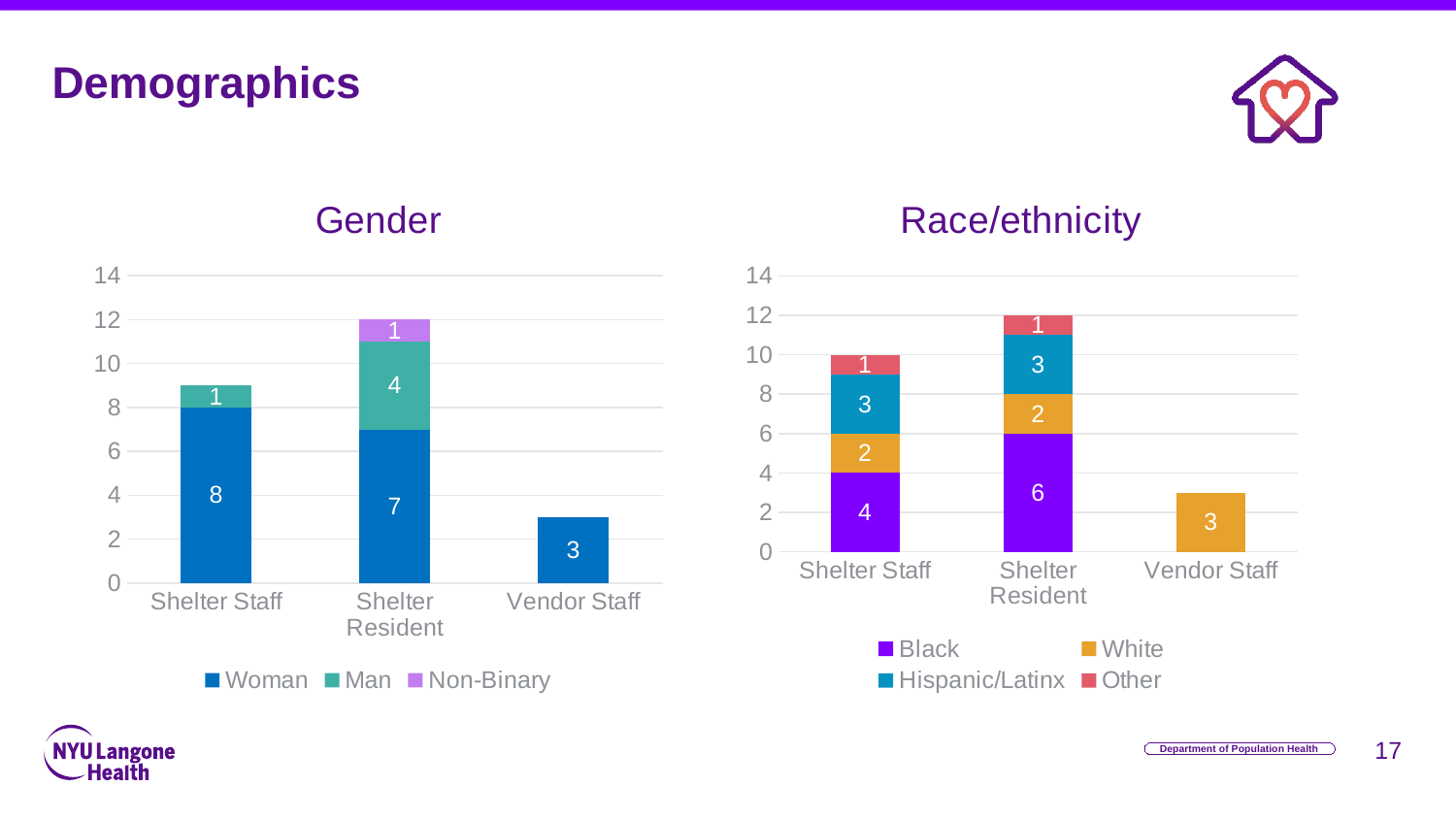
In the Race/ethnicity chart, how many Shelter Resident are Black? 6 In the Gender chart, how many series does the legend list? 3 In the Gender chart, how many Shelter Resident are Man? 4 In the Race/ethnicity chart, which category has the highest total? Shelter Resident What kind of chart is the Gender chart? Stacked bar chart In the Race/ethnicity chart, what is the difference between the Black values for Shelter Resident and Shelter Staff? 2 In the Race/ethnicity chart, what is the total for Shelter Staff? 10 In the Gender chart, what is the total for Shelter Resident? 12 In the Race/ethnicity chart, how many Shelter Staff are Hispanic/Latinx? 3 In the Gender chart, which category has the lowest total? Vendor Staff In the Race/ethnicity chart, how many series does the legend list? 4 In the Gender chart, how many Shelter Staff are Woman? 8